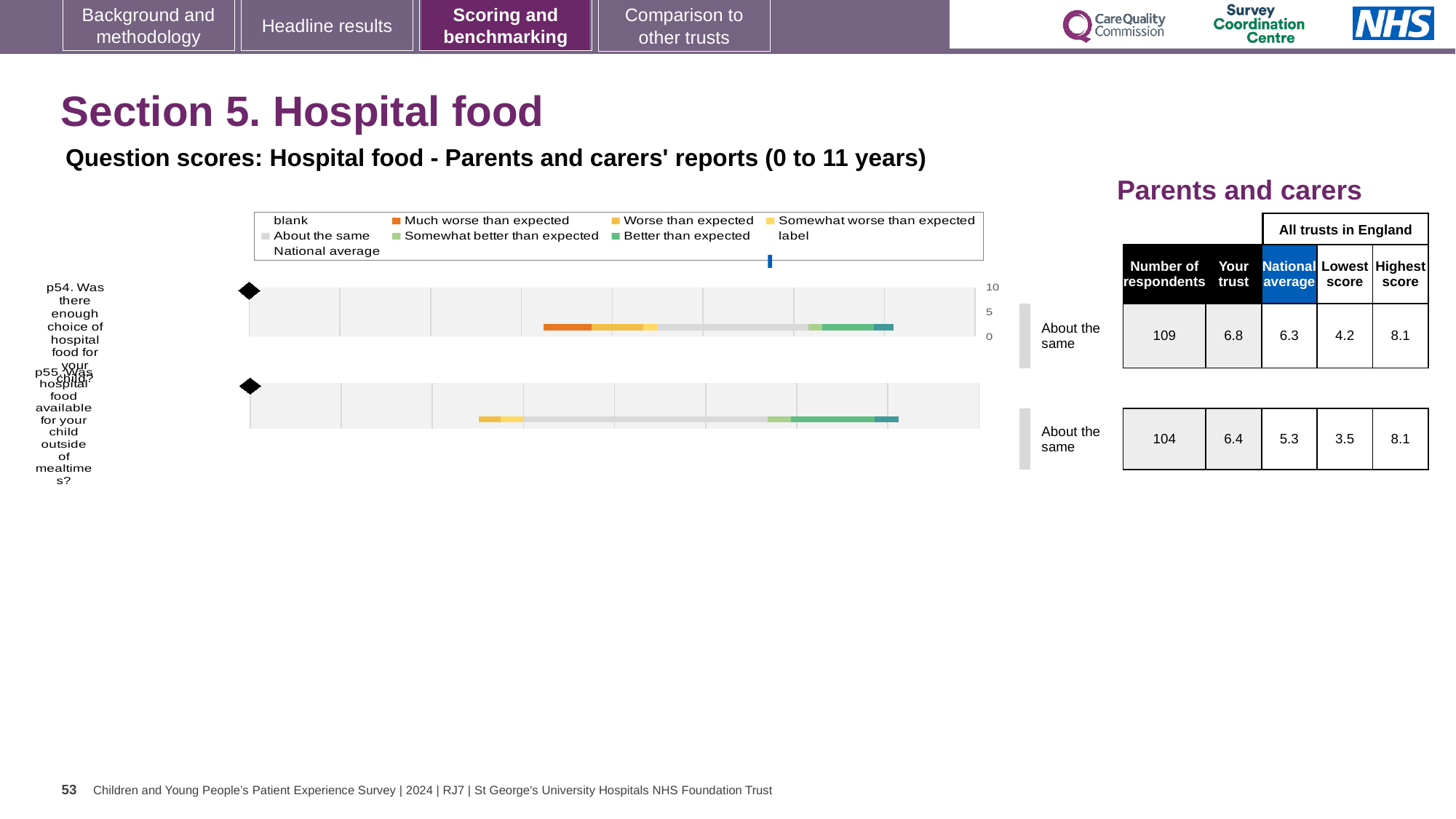
What kind of chart is used to show the question scores for hospital food? bar chart What is the difference between the 'Your trust' score and the national average for p55? 1.1 In the table next to the chart, what is the national average score for p55 (hospital food available outside of mealtimes)? 5.3 Which question has the higher 'Your trust' score, p54 or p55? p54 For p54, is the 'Your trust' score higher or lower than the national average? higher What is the lowest score among all trusts in England for p55? 3.5 In the table next to the chart, what is the 'Your trust' score for p54 (enough choice of hospital food for your child)? 6.8 What benchmark category is shown for both p54 and p55 in the chart? About the same How many respondents answered p54 according to the table beside the chart? 109 What is the title of the chart on this slide? Question scores: Hospital food - Parents and carers' reports (0 to 11 years) What is the difference between the highest and lowest scores for p54? 3.9 How many survey questions (categories) are plotted in the hospital food chart? 2